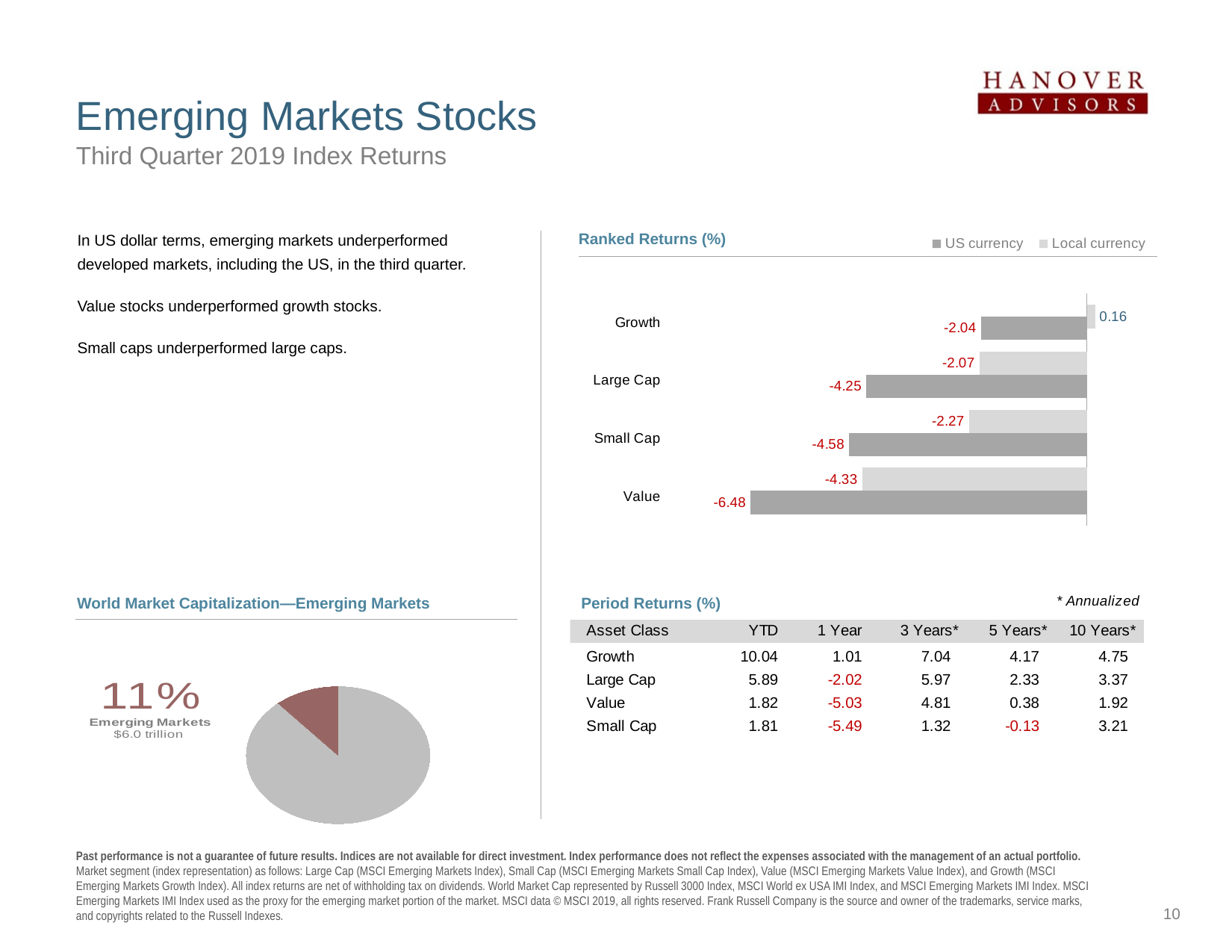
How many series does the legend of the Ranked Returns (%) chart list? 2 In the Ranked Returns (%) chart, what is the Local currency return for Growth? 0.16 In the Ranked Returns (%) chart, what is the Local currency return for Small Cap? -2.27 What kind of chart is the Ranked Returns (%) chart? Bar chart In the Ranked Returns (%) chart, what is the difference between the US currency and Local currency returns for Large Cap? 2.18 In the World Market Capitalization—Emerging Markets chart, what share of world market capitalization do emerging markets represent? 11% In the Ranked Returns (%) chart, which category has the lowest US currency return? Value In the Ranked Returns (%) chart, which category has the highest Local currency return? Growth In the Ranked Returns (%) chart, which is larger, the US currency return for Small Cap or the US currency return for Large Cap? Large Cap In the Ranked Returns (%) chart, what is the US currency return for Value? -6.48 What kind of chart is the World Market Capitalization—Emerging Markets chart? Pie chart How many categories are shown in the Ranked Returns (%) chart? 4